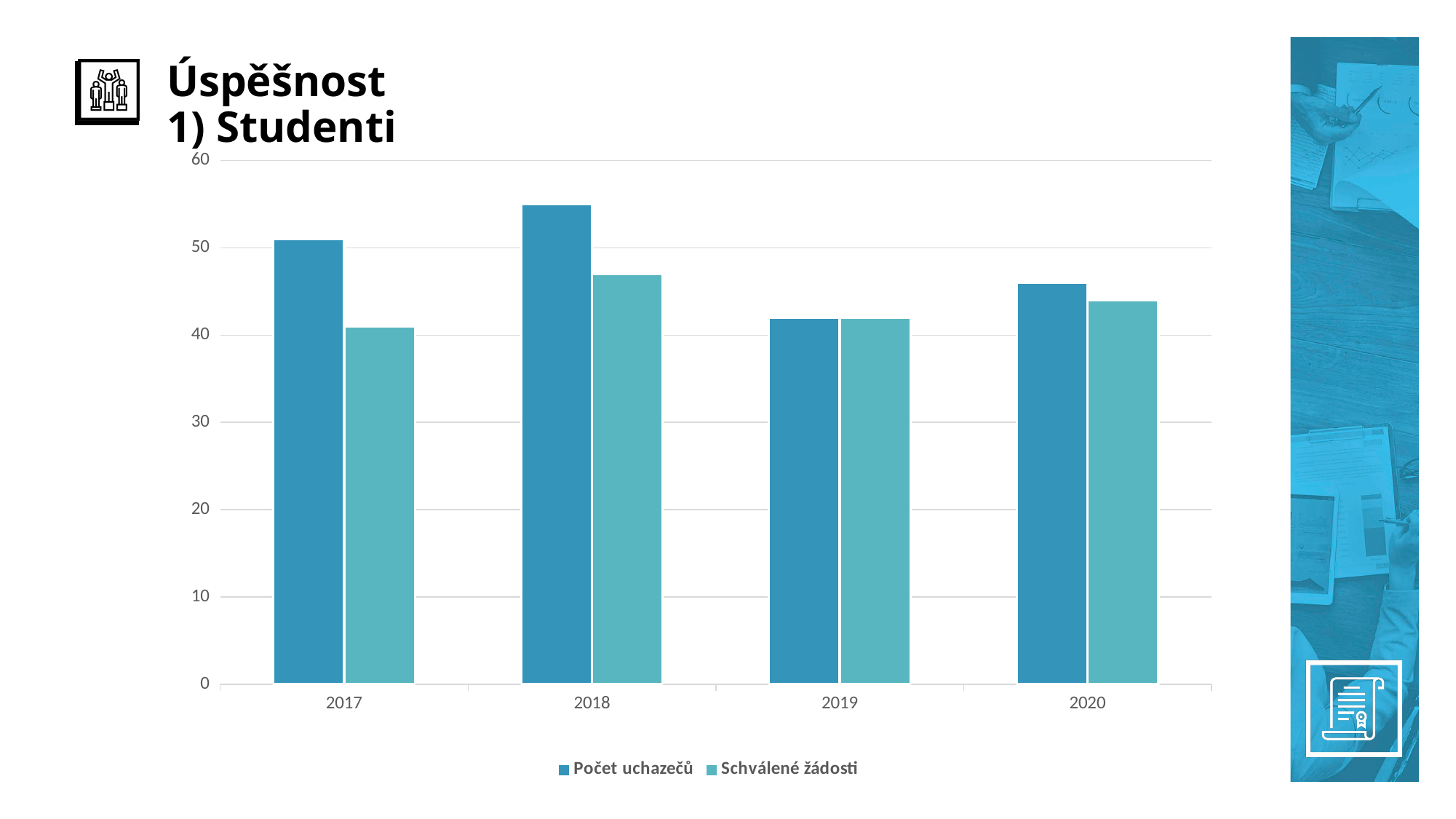
Which year has the highest value for Počet uchazečů? 2018 Is the value for Schválené žádosti in 2019 greater or less than 40? greater Which year has the lowest value for Schválené žádosti? 2017 In 2018, which is larger: Počet uchazečů or Schválené žádosti? Počet uchazečů How many years are shown on the x axis of the chart? 4 How many series does the chart's legend list? 2 Is the value for Počet uchazečů in 2017 greater or less than 50? greater What are the two series named in the chart's legend? Počet uchazečů and Schválené žádosti What kind of chart is shown on the slide? bar chart Which year has the lowest value for Počet uchazečů? 2019 Which is larger: Počet uchazečů in 2018 or Počet uchazečů in 2020? Počet uchazečů in 2018 Is the value for Schválené žádosti in 2018 greater or less than 50? less